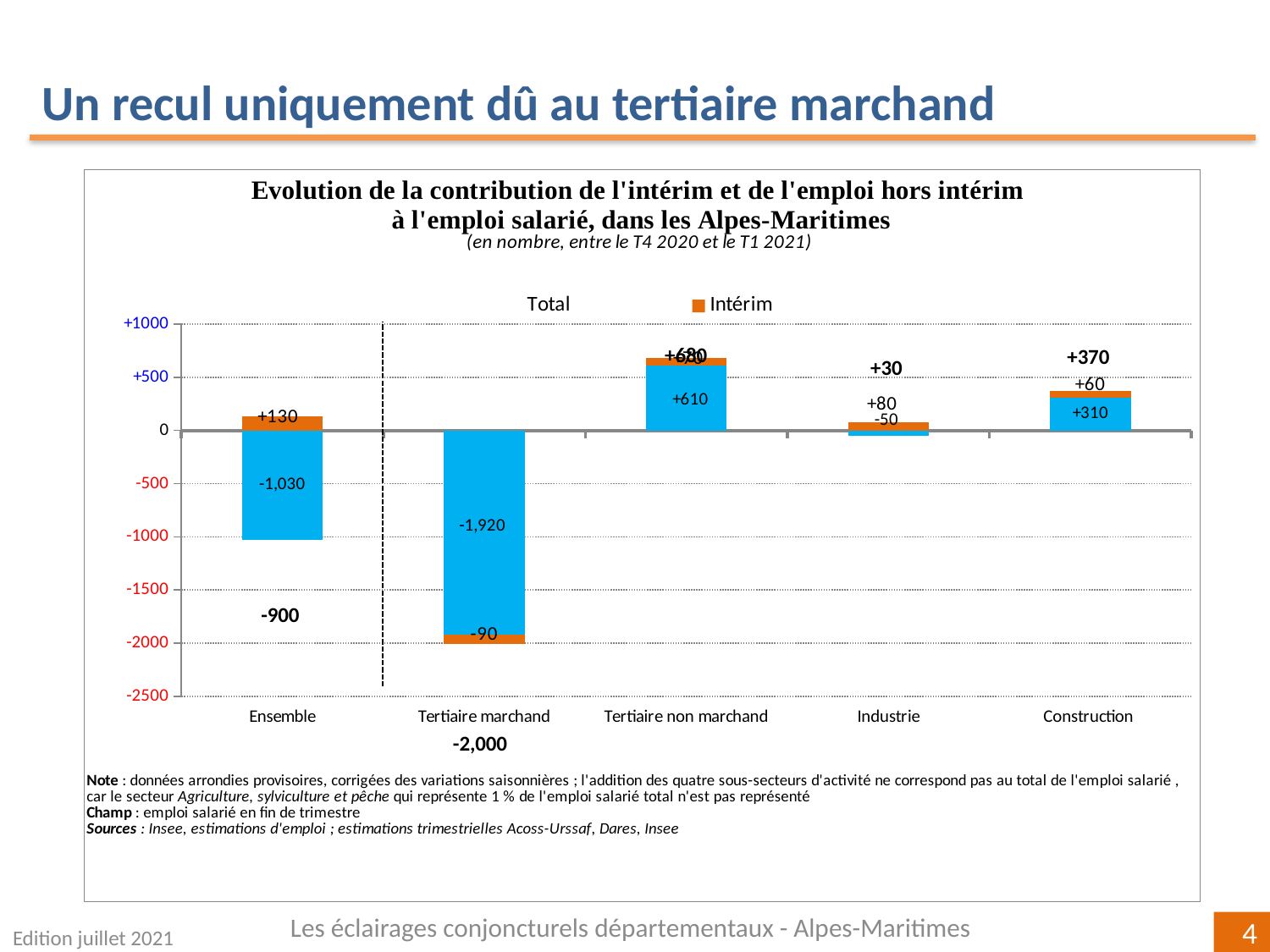
What kind of chart is shown on the slide? bar chart What is the Intérim value for Industrie? +80 What is the value of the blue (hors intérim) bar for Tertiaire marchand? -1,920 What is the Total value shown for Tertiaire marchand? -2,000 What is the Intérim value for Construction? +60 Which category has the lowest Total value? Tertiaire marchand How many categories are shown on the x axis of the chart? 5 Which category has the highest Total value? Tertiaire non marchand What is the Intérim value for Ensemble? +130 What is the Intérim value for Tertiaire marchand? -90 What is the Total value shown for Construction? +370 Which has the larger Intérim value, Industrie or Construction? Industrie